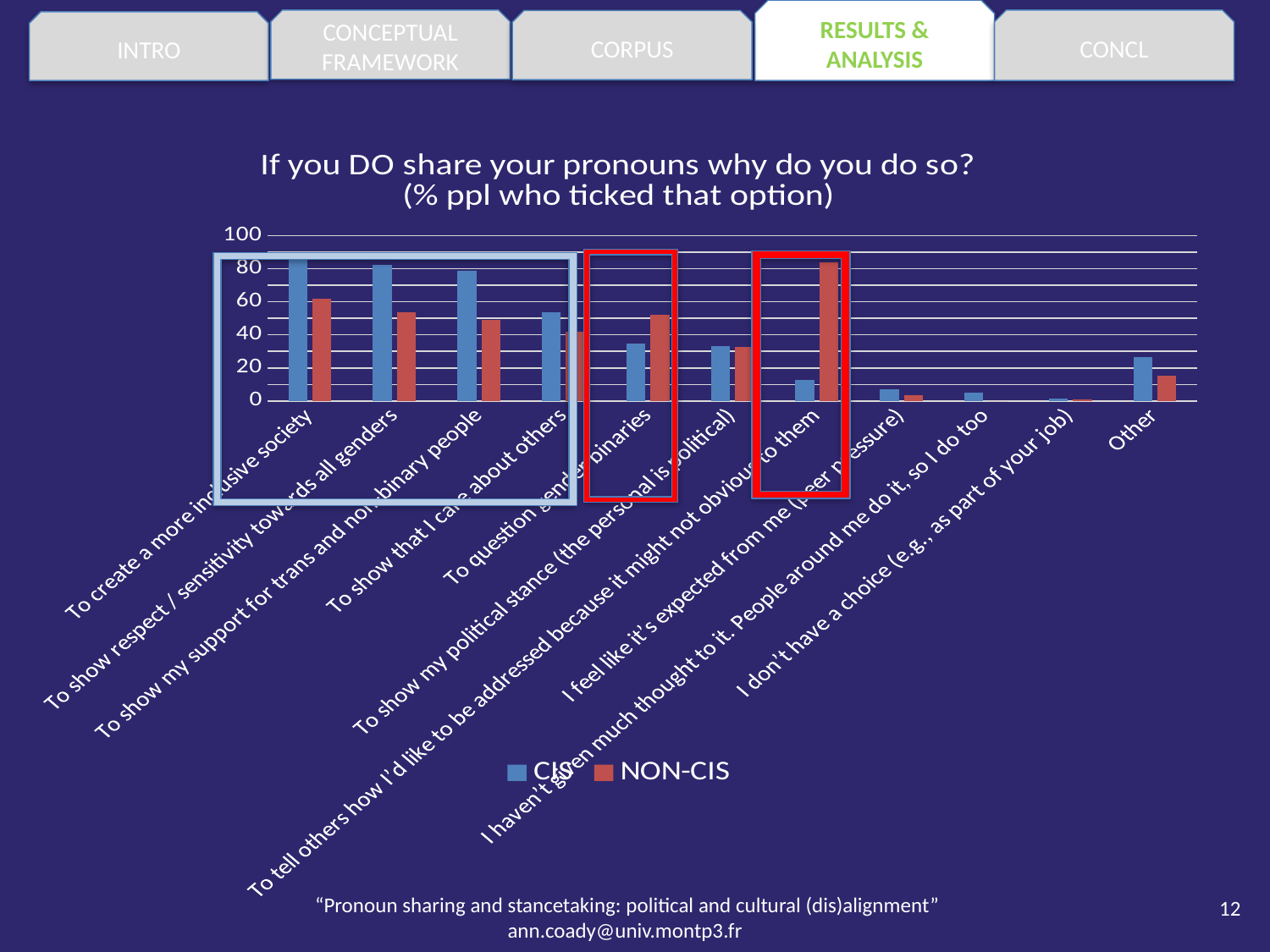
Is the CIS value for 'To create a more inclusive society' greater or less than 80? greater How many categories (reasons) are shown along the x axis? 11 Is the NON-CIS value for 'To create a more inclusive society' greater or less than 80? less Is the NON-CIS value for 'To tell others how I'd like to be addressed because it might not obvious to them' greater or less than 60? greater Which colour represents the NON-CIS series in the legend? red Which category has the highest NON-CIS value? To tell others how I'd like to be addressed because it might not obvious to them How many series does the legend list? 2 For 'To create a more inclusive society', which is larger, the CIS or the NON-CIS value? CIS For 'To tell others how I'd like to be addressed because it might not obvious to them', which is larger, the CIS or the NON-CIS value? NON-CIS Which category has the lowest CIS value? I don't have a choice (e.g., as part of your job) What kind of chart is shown on the slide? bar chart